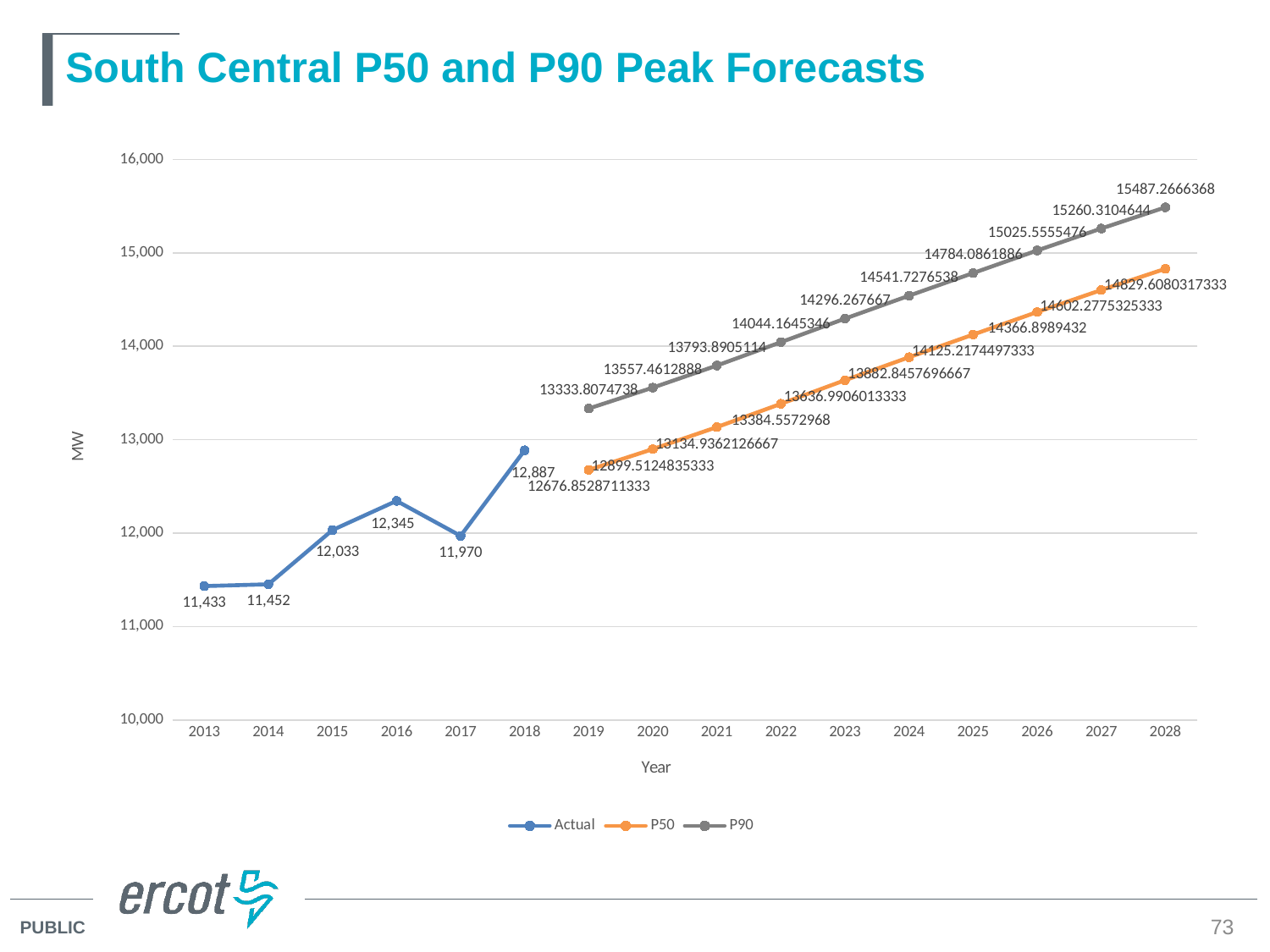
What type of chart is shown on the slide? Line chart What is the P50 value for 2019? 12676.8528711333 What is the P90 value for 2028? 15487.2666368 How many series does the legend list? 3 What is the difference between the Actual values for 2018 and 2017? 917 Is the Actual value for 2017 greater or less than 12,000? less In which year is the Actual series highest? 2018 Does the P50 series rise or fall from 2019 to 2028? Rise In which year is the Actual series lowest? 2013 In 2024, which series has the larger value, P50 or P90? P90 What is the Actual value for 2016? 12,345 What is the Actual value for 2013? 11,433